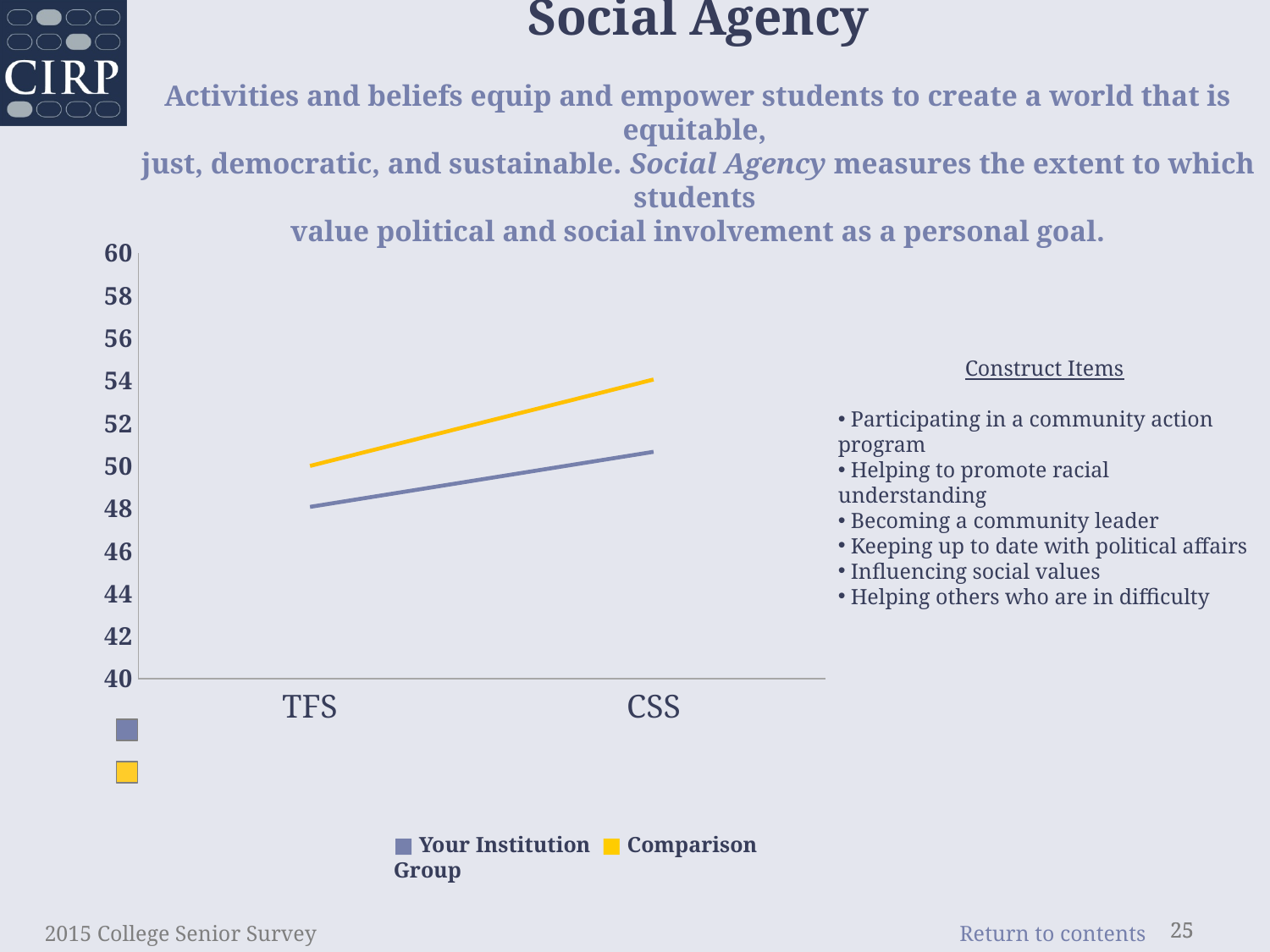
Does the Comparison Group line rise or fall from TFS to CSS? rise How many categories are shown on the x axis of the chart? 2 Is the value for Your Institution at TFS greater or less than 50? less How many series does the chart legend list? 2 Which series is drawn in yellow on the chart? Comparison Group Is the value for Comparison Group at TFS greater or less than 52? less At CSS, which series has the higher value, Your Institution or Comparison Group? Comparison Group Does the Your Institution line rise or fall from TFS to CSS? rise What kind of chart is shown on the slide? line chart At TFS, which series has the lower value, Your Institution or Comparison Group? Your Institution What are the two categories on the x axis of the chart? TFS and CSS Is the value for Comparison Group at CSS greater or less than 52? greater